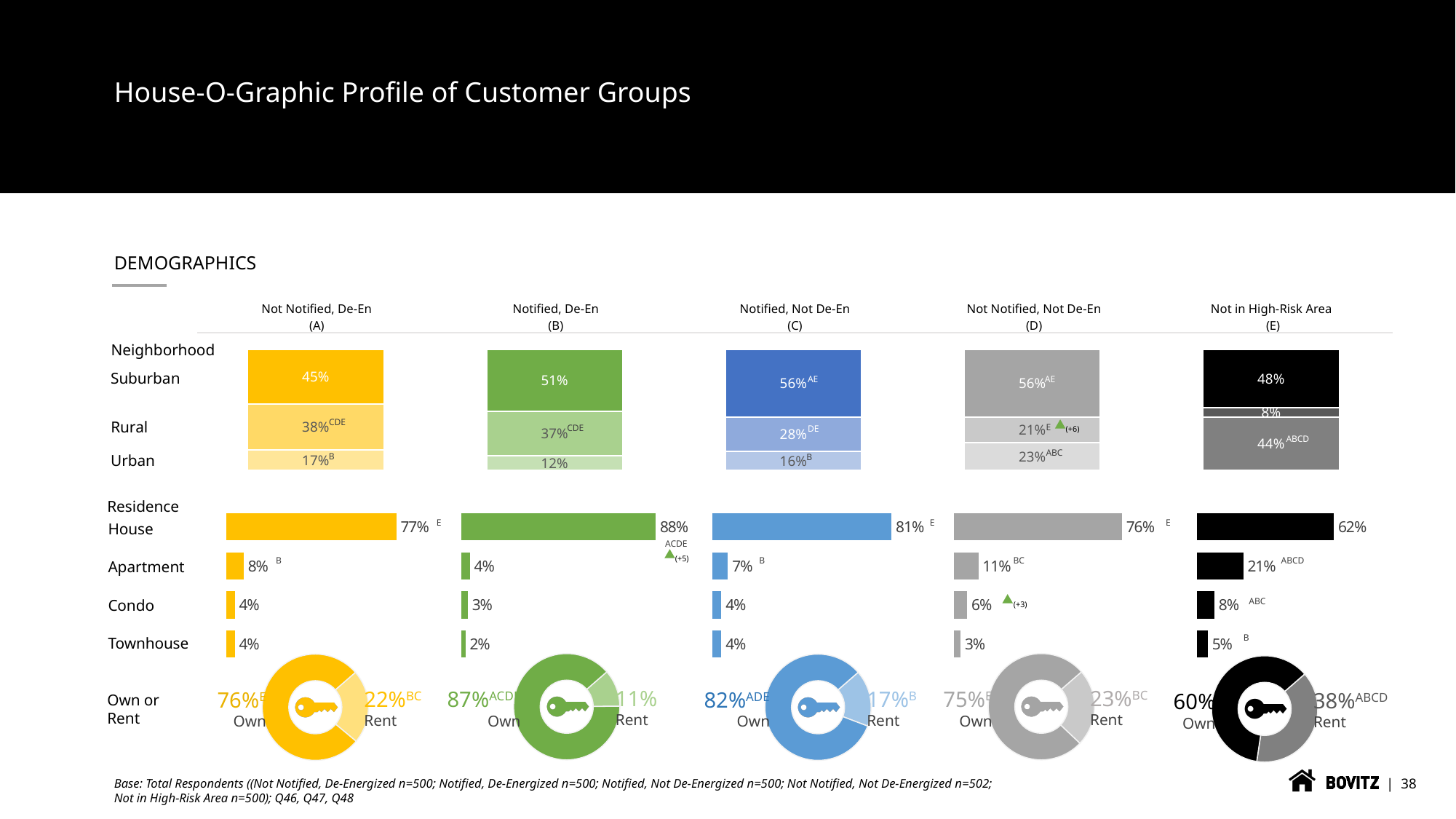
In the Own or Rent donut for Not in High-Risk Area (E), what is the difference between the Own and Rent percentages? 22 percentage points In the Residence bar chart for Not in High-Risk Area (E), which residence type has the highest value? House In the Residence bar charts, is the Apartment value larger for Not Notified, Not De-En (D) or for Not in High-Risk Area (E)? Not in High-Risk Area (E) How many customer groups are compared across the slide? 5 How many residence types are shown in each Residence bar chart? 4 In the Own or Rent donut for Notified, Not De-En (C), what percentage Rent? 17% What kind of chart is used for the Residence section? Bar chart In the Residence bar chart for Notified, De-En (B), which residence type has the lowest value? Townhouse In the Neighborhood charts, how much higher is the Suburban value for Notified, Not De-En (C) than for Not Notified, De-En (A)? 11 percentage points In the Residence bar chart for Notified, De-En (B), what percentage live in a House? 88% In the Neighborhood stacked bar for Not Notified, De-En (A), what is the Rural value? 38% In the Neighborhood stacked bar for Notified, De-En (B), what is the total of the Suburban, Rural and Urban segments? 100%